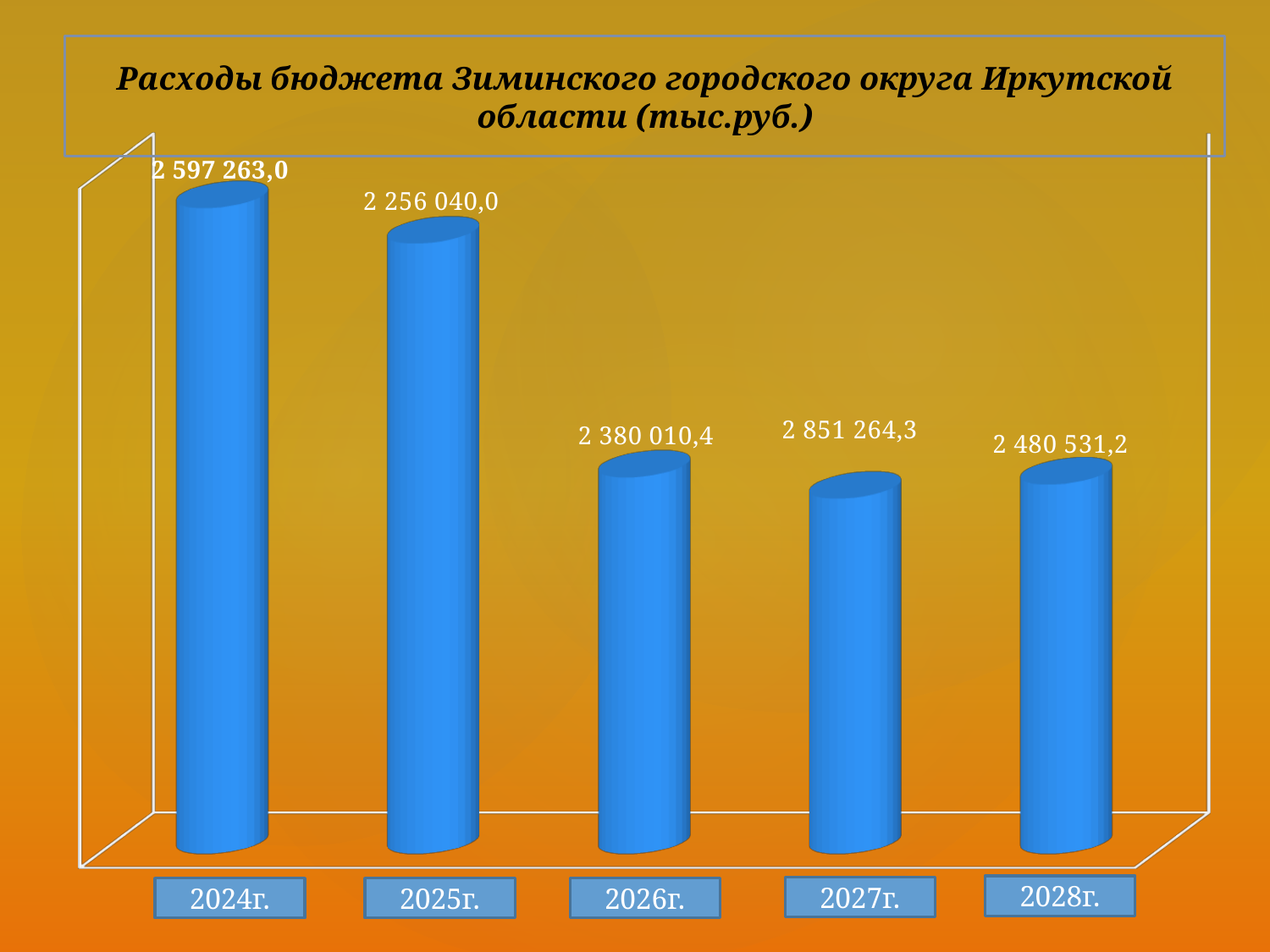
What is the budget expenditure value shown for 2024г.? 2 597 263,0 What kind of chart is shown on the slide? Bar chart How many years (categories) are shown on the chart? 5 What is the value shown for 2025г.? 2 256 040,0 What is the value shown for 2027г.? 2 851 264,3 What is the value shown for 2026г.? 2 380 010,4 What is the difference between the values for 2028г. and 2026г.? 100 520,8 What is the title of the chart? Расходы бюджета Зиминского городского округа Иркутской области (тыс.руб.) What is the difference between the values for 2027г. and 2026г.? 471 253,9 In what units are the values on the chart expressed, according to the title? тыс.руб. What is the value shown for 2028г.? 2 480 531,2 What is the difference between the values for 2024г. and 2025г.? 341 223,0